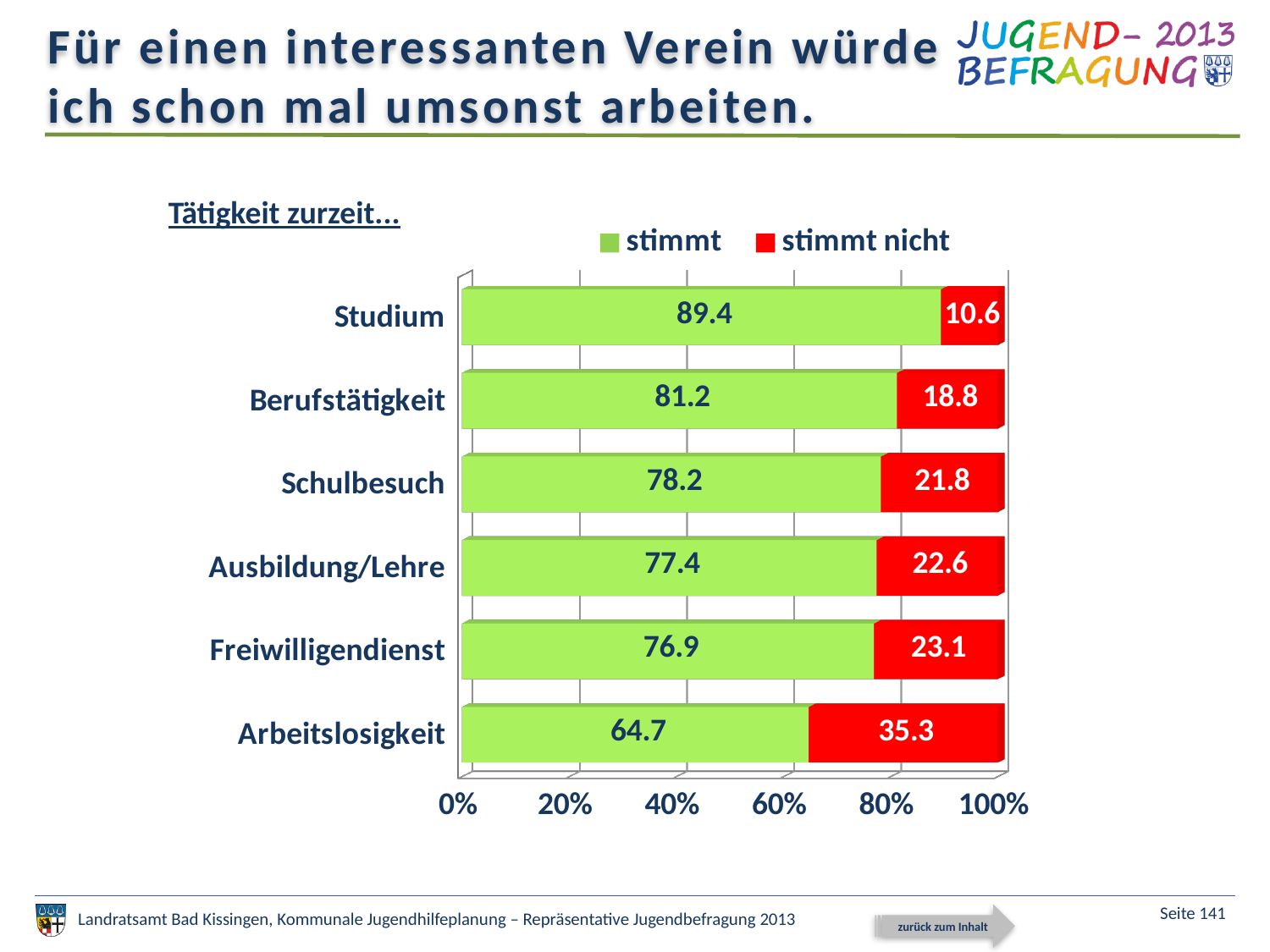
What colour represents 'stimmt nicht' in the chart? Red What is the 'stimmt' value for Studium? 89.4 What kind of chart is shown on the slide? Stacked bar chart What is the total of the stacked bar for Schulbesuch? 100 Which category has the lowest 'stimmt' value? Arbeitslosigkeit Which category has the highest 'stimmt' value? Studium What is the 'stimmt' value for Freiwilligendienst? 76.9 Which is larger: the 'stimmt nicht' value for Ausbildung/Lehre or for Studium? Ausbildung/Lehre How many categories are shown on the chart? 6 What is the 'stimmt nicht' value for Arbeitslosigkeit? 35.3 How many series does the legend list? 2 What is the difference between the 'stimmt' values for Berufstätigkeit and Schulbesuch? 3